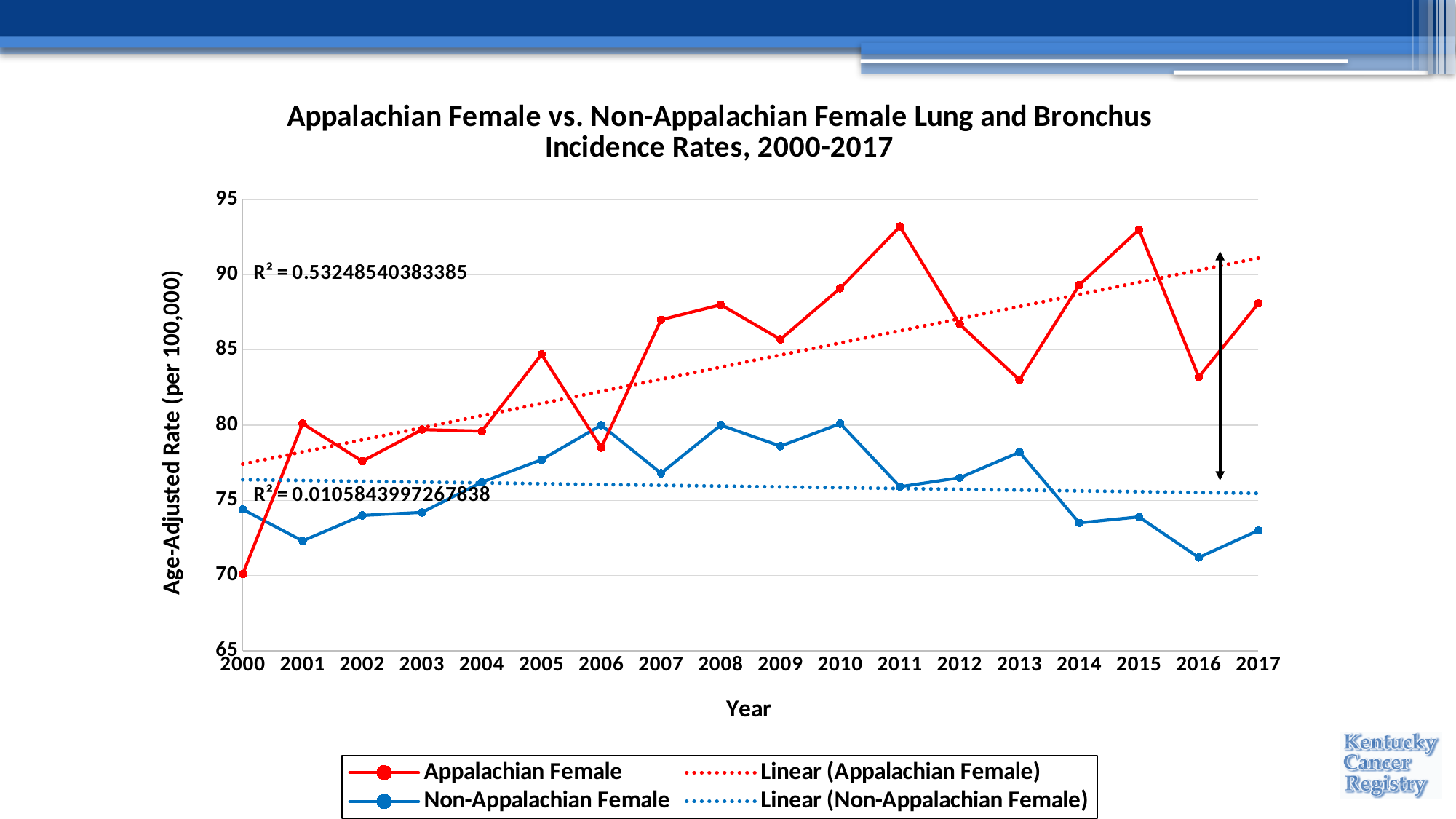
How many years are plotted along the x axis? 18 Is the Non-Appalachian Female rate in 2016 greater or less than 75? less In 2006, which series has the higher rate, Appalachian Female or Non-Appalachian Female? Non-Appalachian Female Is the Appalachian Female rate in 2011 greater or less than 90? greater Is the Appalachian Female rate in 2013 greater or less than 85? less What R² value is shown for the Appalachian Female trendline? 0.53248540383385 In which year is the Appalachian Female rate lowest? 2000 How many entries does the legend list? 4 Does the linear trendline for Appalachian Female rise or fall from 2000 to 2017? Rise What kind of chart is shown on the slide? Line chart In which year is the Non-Appalachian Female rate lowest? 2016